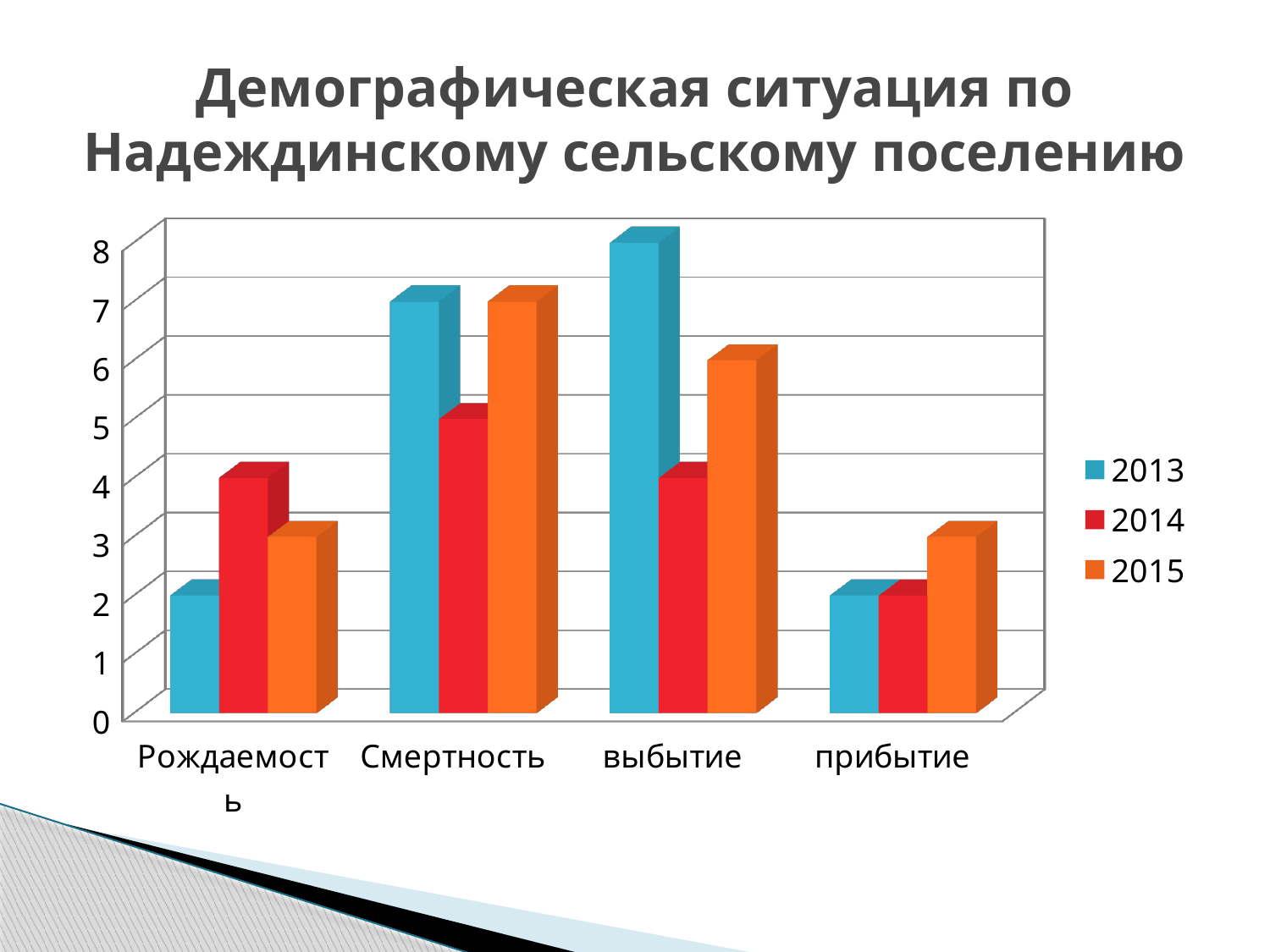
How many categories are shown on the x axis? 4 What kind of chart is shown on the slide? bar chart Is the value for прибытие in 2014 greater or less than 4? less What is the value for Рождаемость in 2013? 2 What is the value for Смертность in 2014? 5 What is the value for выбытие in 2013? 8 Is the value for Смертность in 2015 greater or less than 5? greater Which is larger for выбытие: the 2014 value or the 2015 value? 2015 Which year does the orange series in the legend represent? 2015 Which category has the highest value for 2013? выбытие How many series does the legend list? 3